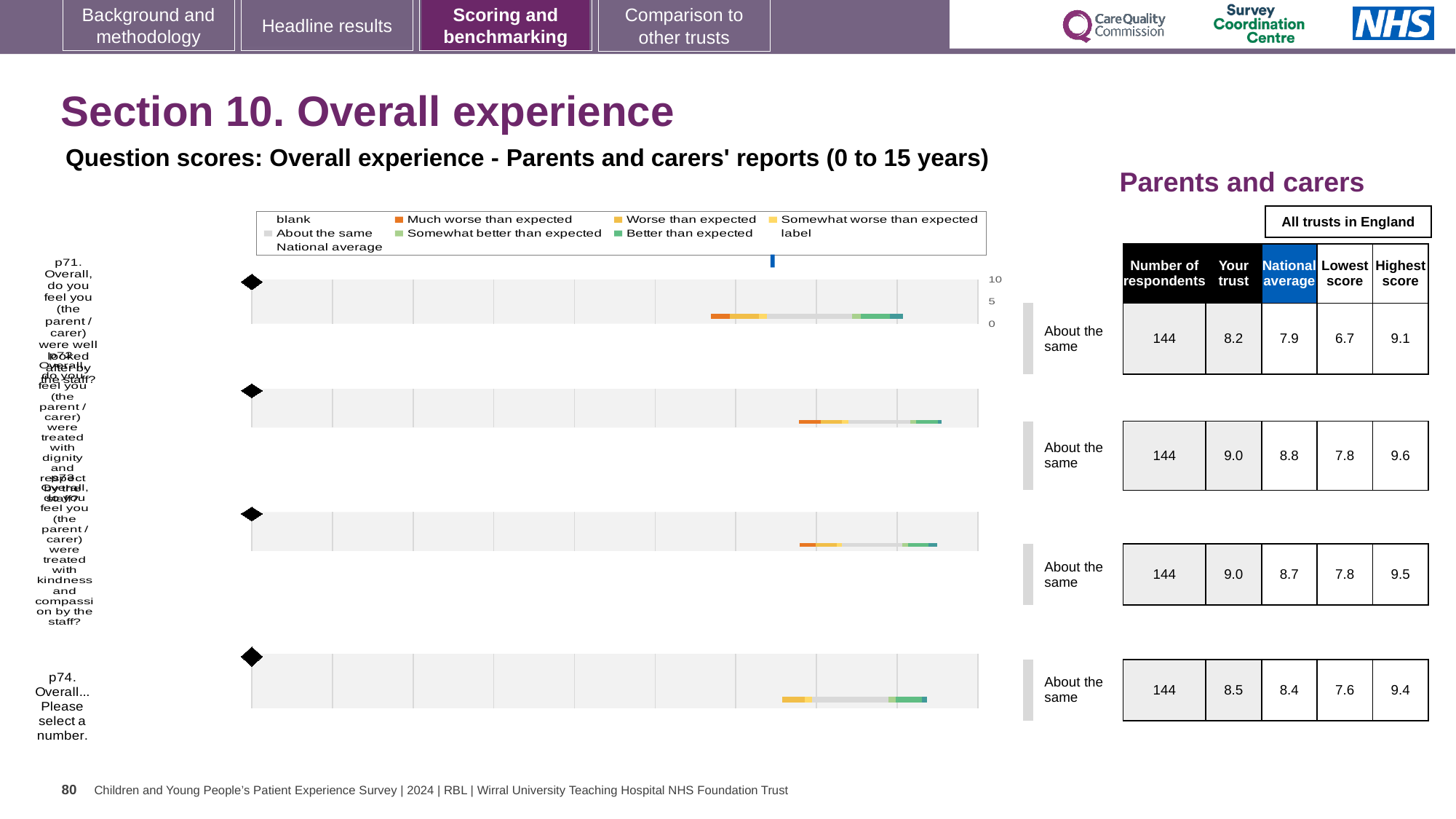
What kind of chart is used to show the question scores on this slide? bar chart What is the lowest score among all trusts in England for question p73? 7.8 What is the difference between the 'Your trust' score and the national average for question p71? 0.3 For question p74, which is larger: the 'Your trust' score or the national average? Your trust How many questions (rows) are plotted in the chart? 4 Which question has the lowest 'Your trust' score? p71 How many respondents are shown for question p72? 144 What is the 'Your trust' score for question p71 (well looked after by the staff)? 8.2 Which benchmarking category is the trust placed in for all four questions in the chart? About the same What is the highest score among all trusts in England for question p72? 9.6 What is the difference between the highest and lowest scores for question p74? 1.8 What is the national average score for question p74 (Overall... Please select a number)? 8.4